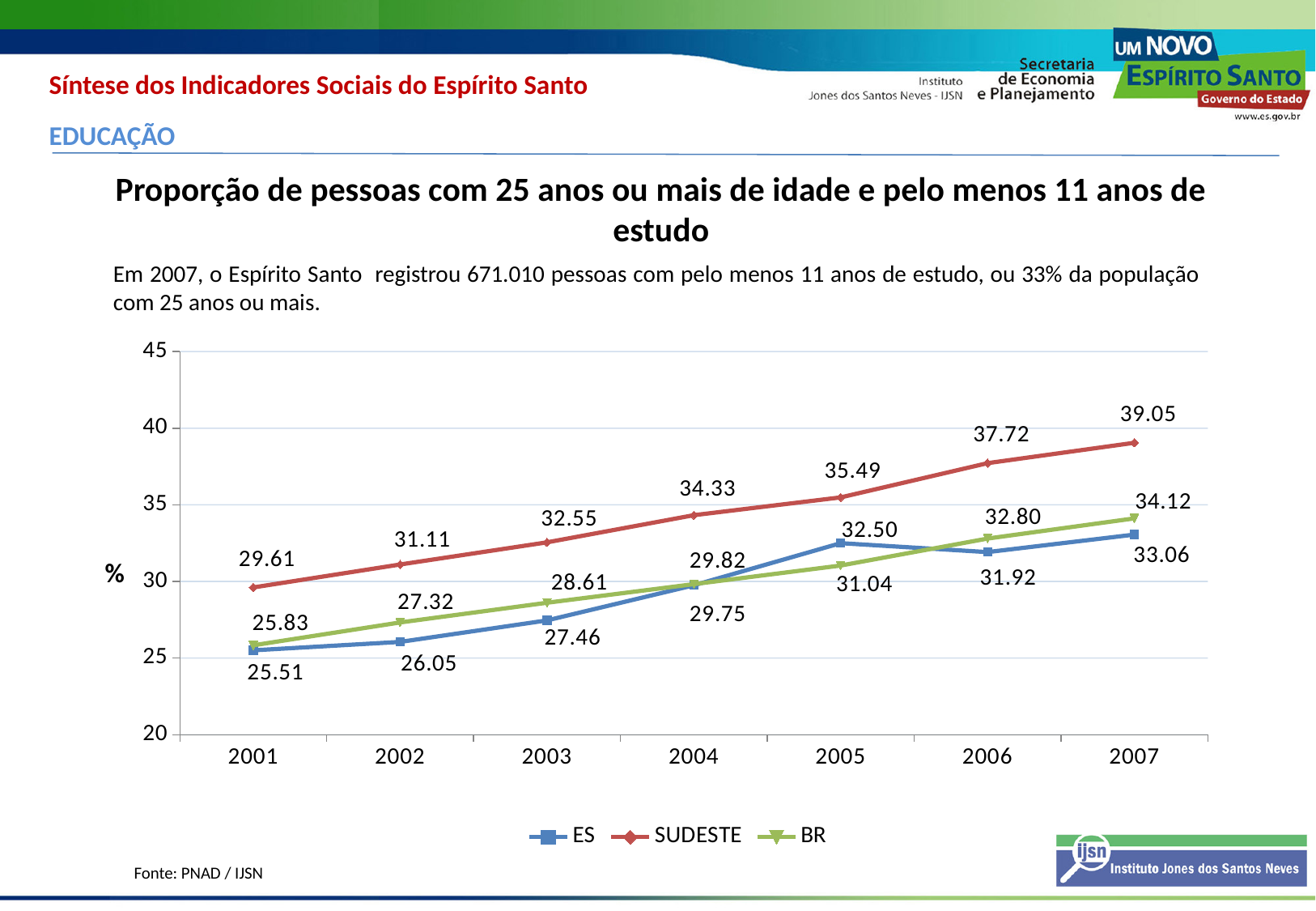
What is the value for ES in 2005? 32.50 What is the value for SUDESTE in 2007? 39.05 What is the value for BR in 2003? 28.61 In which year is the ES series at its lowest value? 2001 Which series has the highest value in 2007? SUDESTE How many years are shown on the x axis? 7 Which is larger in 2006, the value for ES or the value for BR? BR What kind of chart is shown on the slide? Line chart What is the difference between the SUDESTE and ES values in 2007? 5.99 How many series does the legend list? 3 What is the value for ES in 2001? 25.51 Does the SUDESTE series rise or fall from 2001 to 2007? Rise